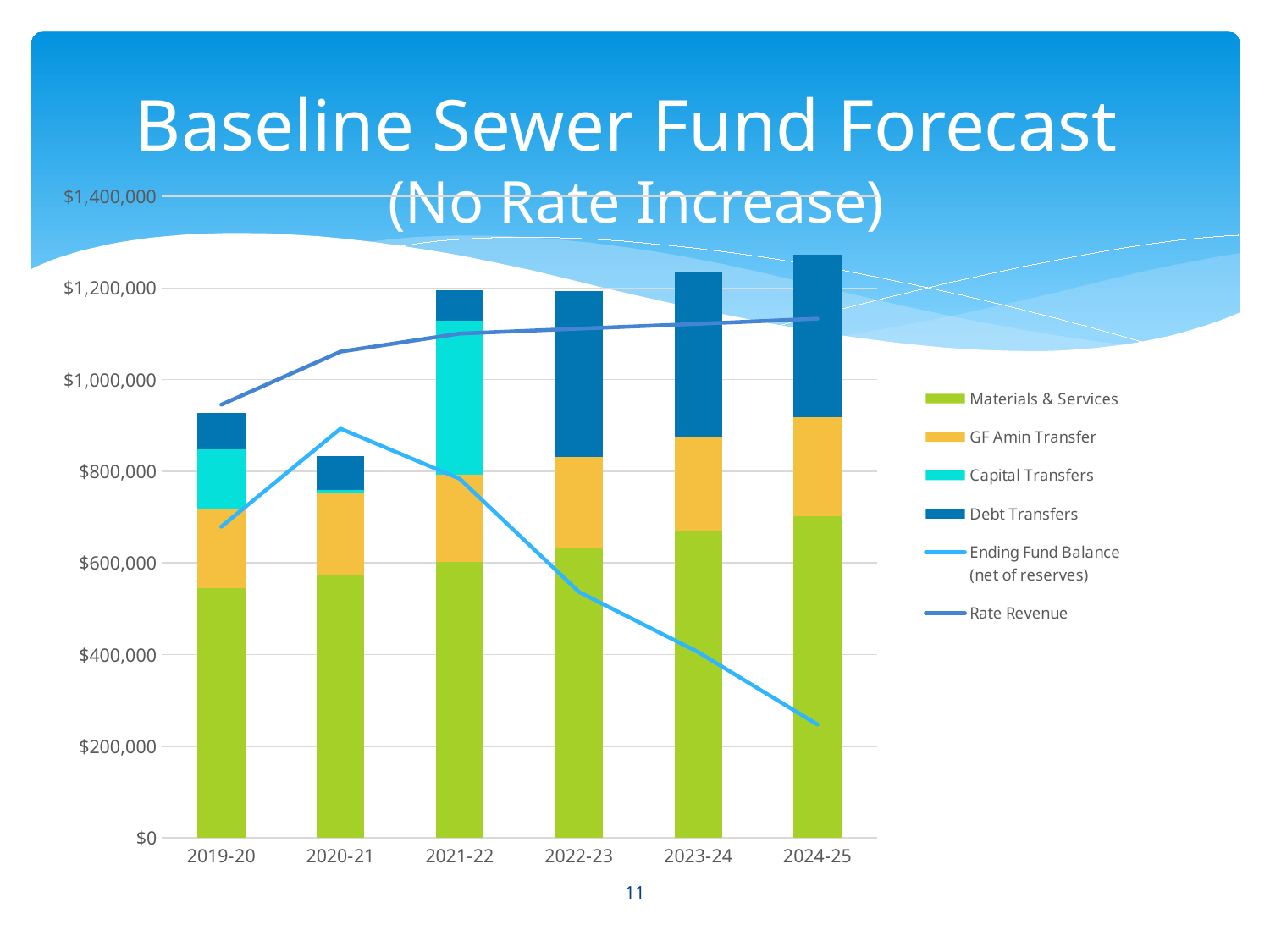
In which fiscal year is the Ending Fund Balance (net of reserves) lowest? 2024-25 Which fiscal year has the largest Capital Transfers segment? 2021-22 Which fiscal year has the shortest stacked bar? 2020-21 Is the Ending Fund Balance (net of reserves) for 2024-25 greater or less than $400,000? less In which fiscal year does the Ending Fund Balance (net of reserves) line reach its highest point? 2020-21 How many fiscal years are shown on the x axis? 6 Does the Rate Revenue line rise or fall from 2019-20 to 2024-25? Rises Is the total stacked bar for 2024-25 greater or less than $1,200,000? greater Which fiscal year has the tallest stacked bar? 2024-25 Is the Rate Revenue for 2019-20 greater or less than $1,000,000? less What kind of chart is shown on the slide? A stacked bar chart combined with line series How many series does the legend list? 6